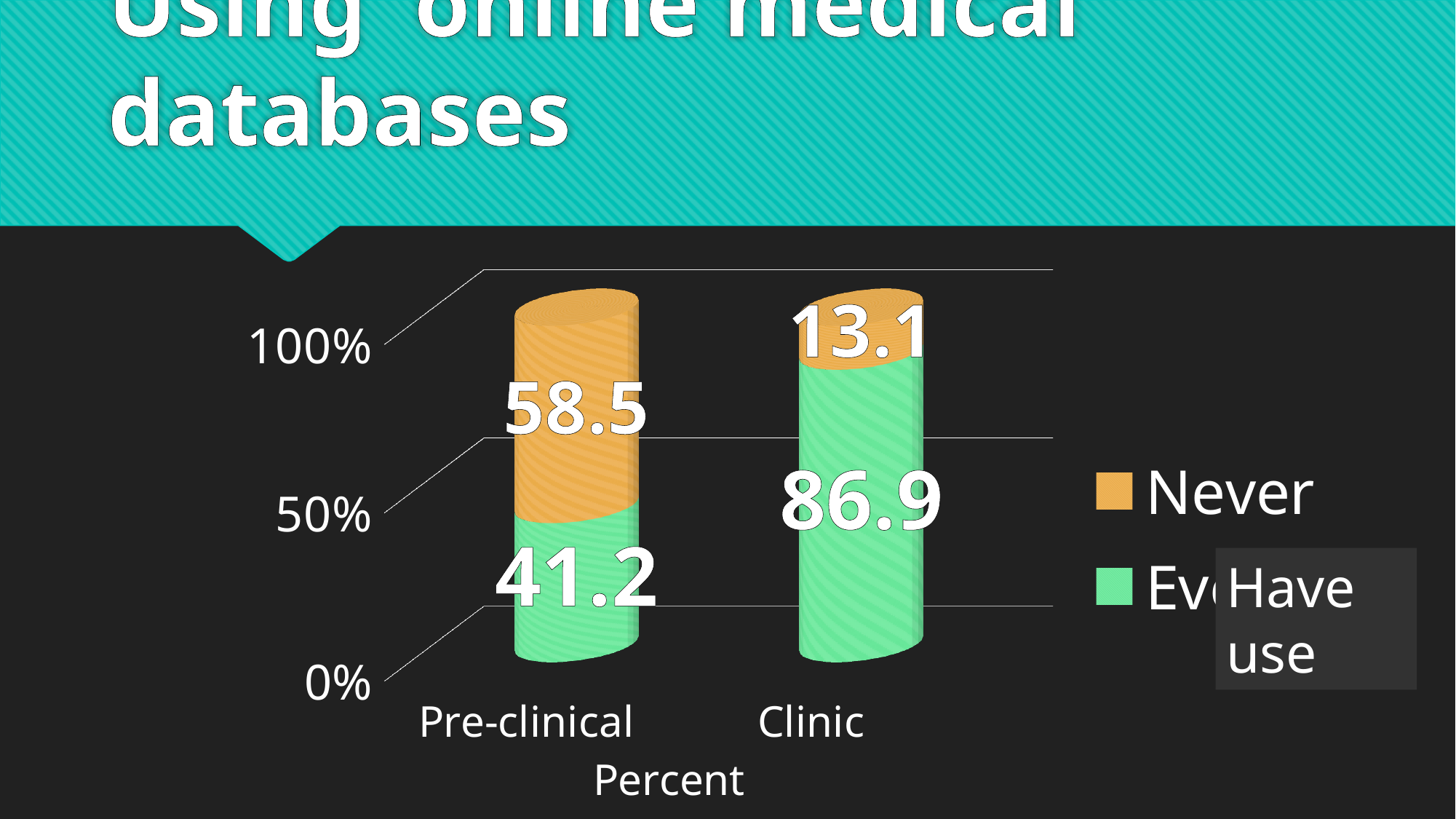
How many series does the legend list? 2 Which category has the higher 'Never' value? Pre-clinical What is the 'Never' value for Pre-clinical? 58.5 What is the difference between the green segment values for Clinic and Pre-clinical? 45.7 What type of chart is shown on the slide? stacked bar chart What is the difference between the 'Never' values for Pre-clinical and Clinic? 45.4 What is the value of the green segment for Pre-clinical? 41.2 How many categories are shown on the x axis? 2 What is the value of the green segment for Clinic? 86.9 Is the 'Never' value for Pre-clinical larger than the green segment value for Pre-clinical? Yes What is the 'Never' value for Clinic? 13.1 Which category has the lower value for the green segment? Pre-clinical